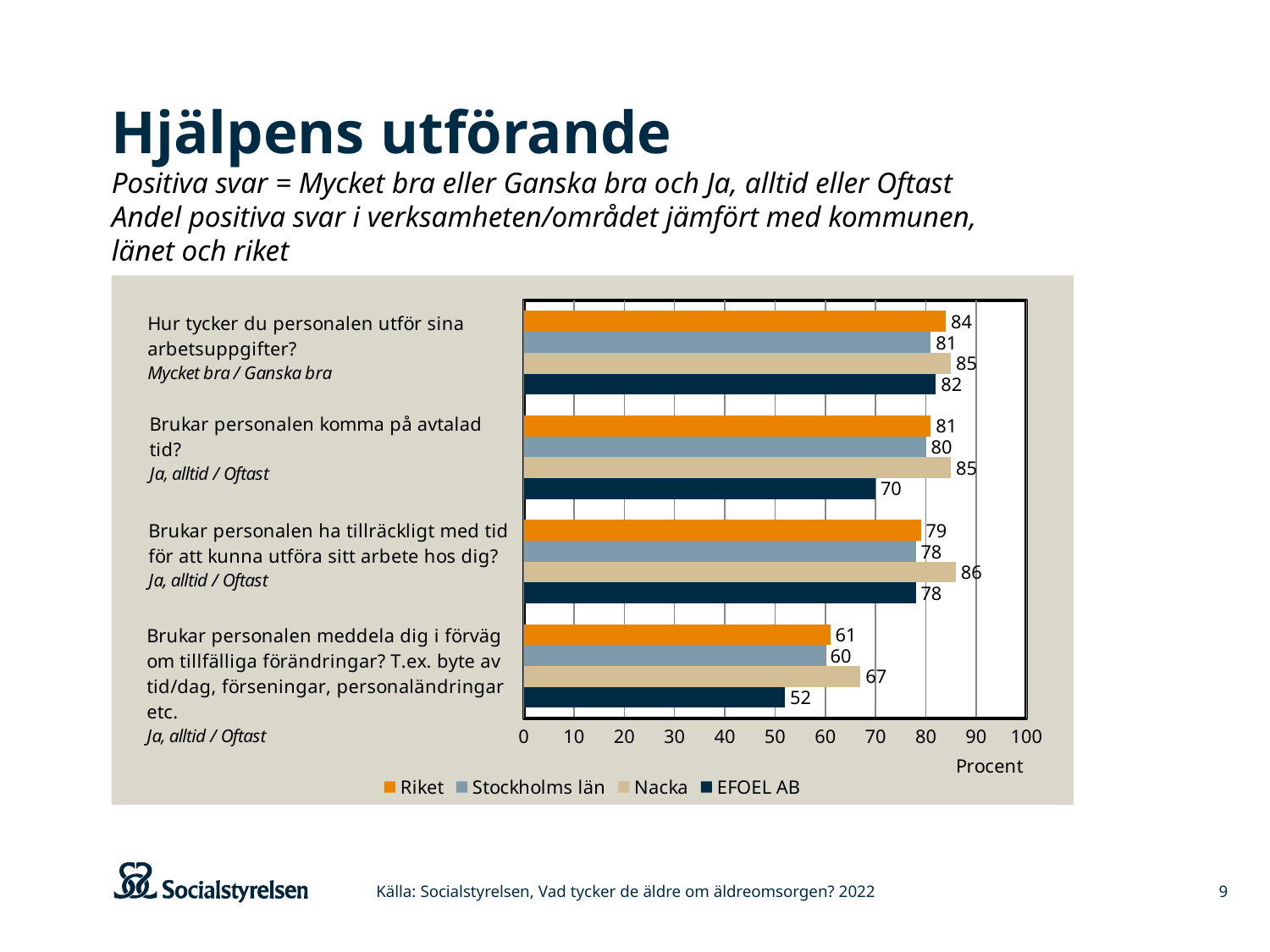
Which series has the lowest value for the question "Brukar personalen meddela dig i förväg om tillfälliga förändringar?"? EFOEL AB What is the value for EFOEL AB for the question "Brukar personalen komma på avtalad tid?"? 70 What kind of chart is shown on the slide? Bar chart What is the value for Riket for the question "Hur tycker du personalen utför sina arbetsuppgifter?"? 84 How many series does the legend list? 4 What is the value for Nacka for the question "Brukar personalen ha tillräckligt med tid för att kunna utföra sitt arbete hos dig?"? 86 What is the value for Stockholms län for the question "Brukar personalen meddela dig i förväg om tillfälliga förändringar?"? 60 Which series has the highest value for the question "Brukar personalen komma på avtalad tid?"? Nacka How many question categories are shown on the chart? 4 What is the difference between the Nacka and EFOEL AB values for the question "Brukar personalen komma på avtalad tid?"? 15 For the question "Hur tycker du personalen utför sina arbetsuppgifter?", which is larger: the value for Riket or the value for Stockholms län? Riket What is the label of the horizontal axis of the chart? Procent